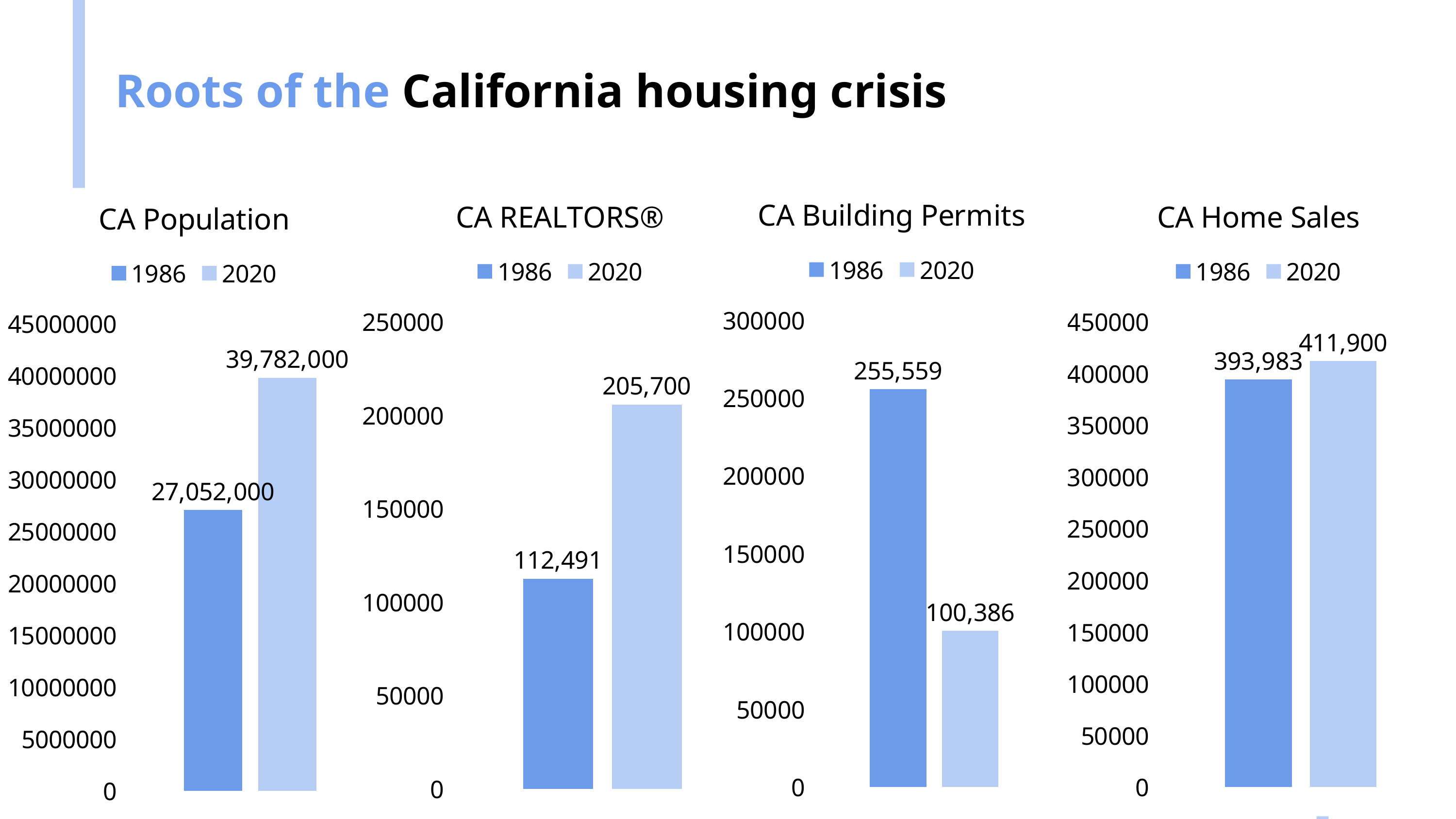
In the CA Population chart, what is the value for 1986? 27,052,000 In the CA REALTORS® chart, what is the value for 2020? 205,700 In the CA REALTORS® chart, what is the difference between the 2020 and 1986 values? 93,209 In the CA Building Permits chart, what is the value for 1986? 255,559 In the CA Building Permits chart, which year has the lower value? 2020 In the CA Home Sales chart, what is the value for 2020? 411,900 In the CA Population chart, what is the value for 2020? 39,782,000 In the CA REALTORS® chart, which year has the higher value? 2020 How many series does the legend of the CA Population chart list? 2 What kind of chart is the CA Home Sales chart? bar chart In the CA Home Sales chart, is the value for 1986 larger or smaller than the value for 2020? smaller In the CA Building Permits chart, what is the difference between the 1986 and 2020 values? 155,173